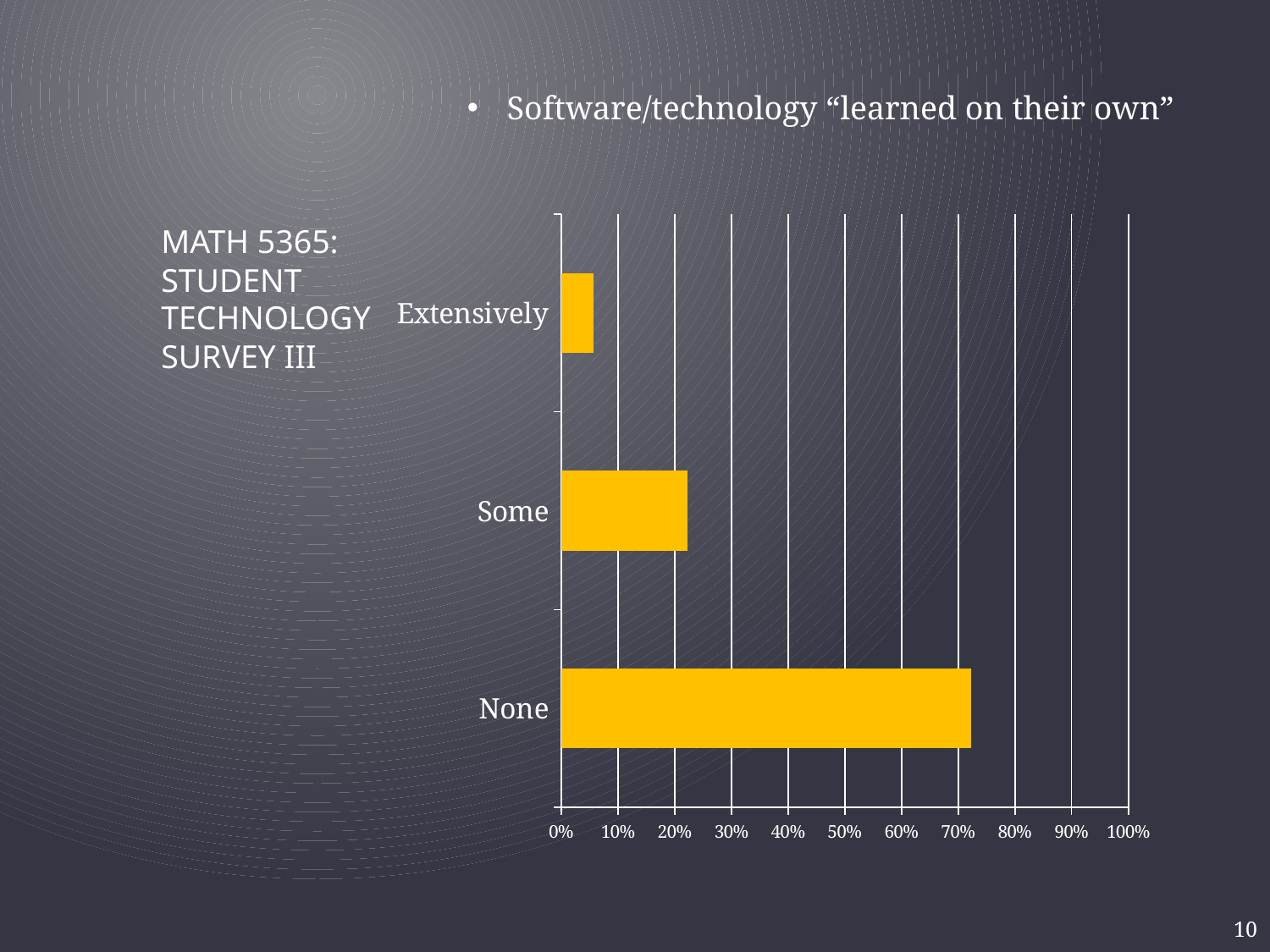
What is the highest value shown on the horizontal axis? 100% Which is larger, the value for None or the value for Some? None What colour are the bars in the chart? yellow Which is larger, the value for Some or the value for Extensively? Some How many categories does the chart show? 3 Is the value for Some greater or less than 30%? less Which category has the highest value? None Is the value for None greater or less than 80%? less What kind of chart is shown on the slide? bar chart Is the value for Extensively greater or less than 10%? less Which category has the lowest value? Extensively